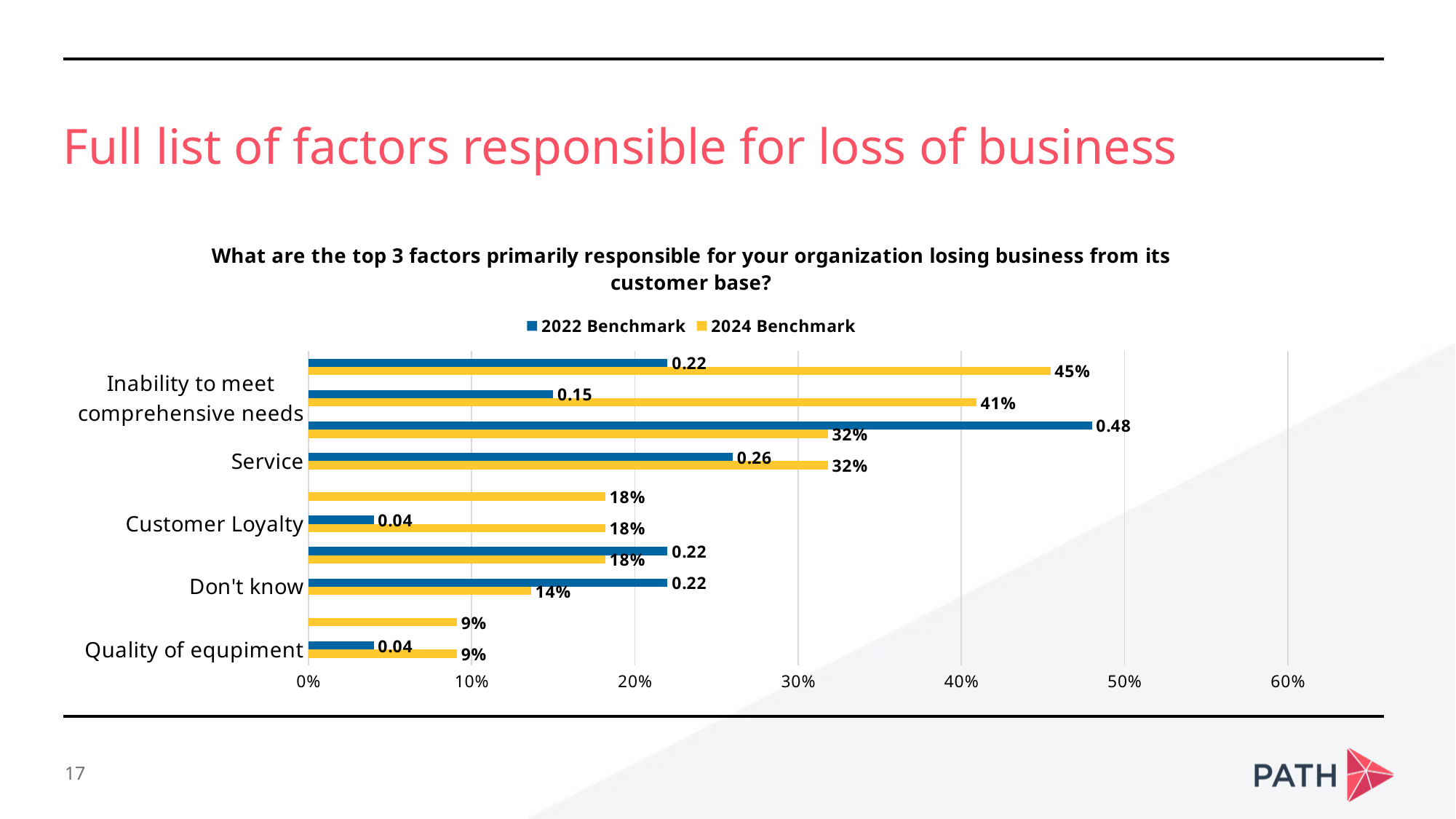
What are the two series named in the legend? 2022 Benchmark and 2024 Benchmark What is the 2022 Benchmark value for Service? 0.26 What is the highest 2024 Benchmark value shown on the chart? 45% What is the 2024 Benchmark value for Don't know? 14% What is the lowest 2024 Benchmark value shown on the chart? 9% What is the 2024 Benchmark value for Quality of equpiment? 9% What is the 2024 Benchmark value for Service? 32% How many series does the legend list? 2 Which colour represents the 2024 Benchmark series? yellow What is the highest 2022 Benchmark value shown on the chart? 0.48 What kind of chart is shown on the slide? bar chart Is the 2024 Benchmark value for Customer Loyalty greater or less than 20%? less